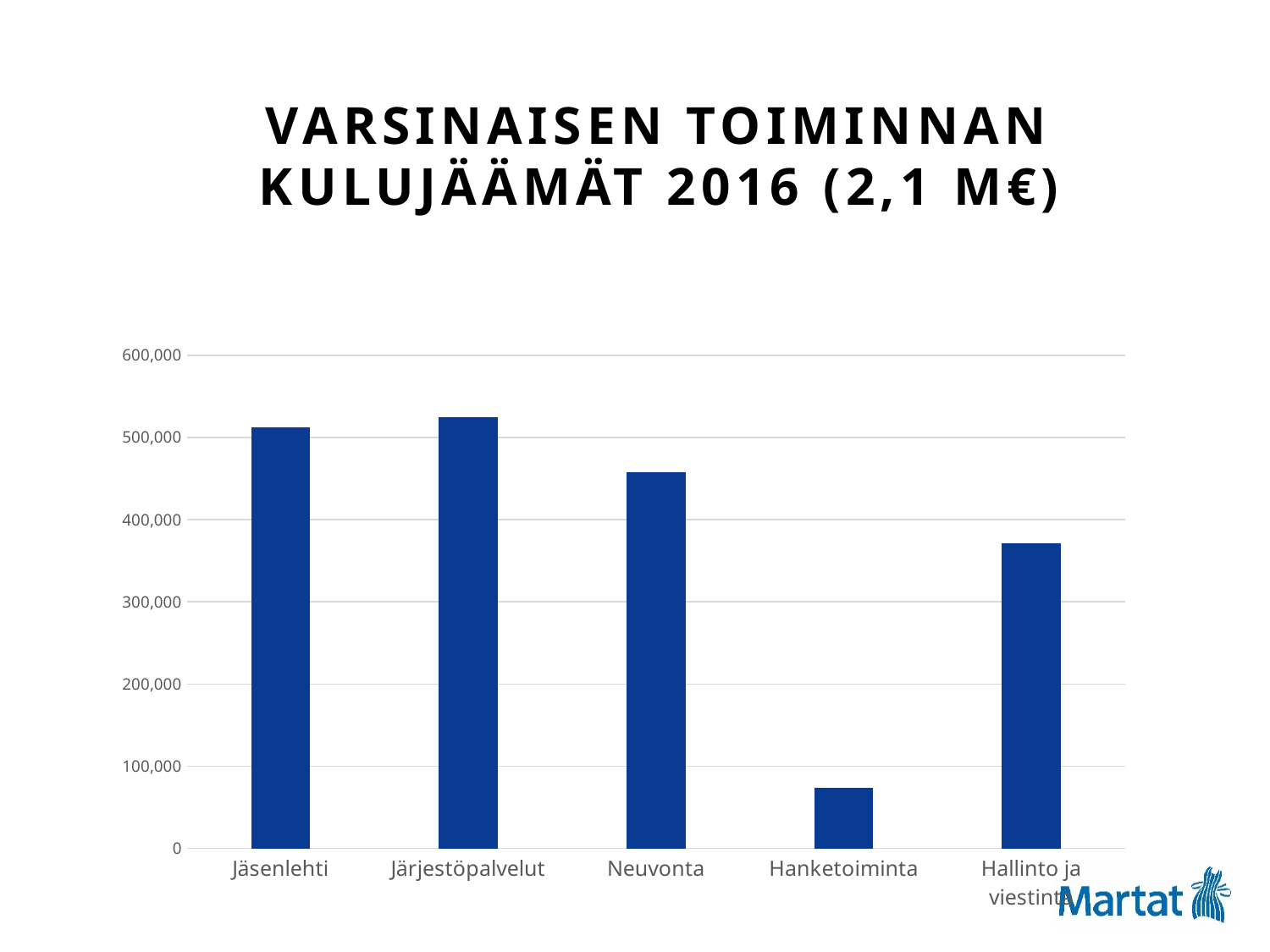
Is the value for Hanketoiminta greater or less than 100,000? less What is the title of the chart on the slide? VARSINAISEN TOIMINNAN KULUJÄÄMÄT 2016 (2,1 M€) How many categories are shown on the x axis of the chart? 5 Is the value for Hallinto ja viestintä greater or less than 400,000? less Is the value for Järjestöpalvelut greater or less than 500,000? greater Which category has the lowest value in the chart? Hanketoiminta What kind of chart is shown on the slide? bar chart Which has the larger value, Neuvonta or Hallinto ja viestintä? Neuvonta Which has the larger value, Hanketoiminta or Hallinto ja viestintä? Hallinto ja viestintä